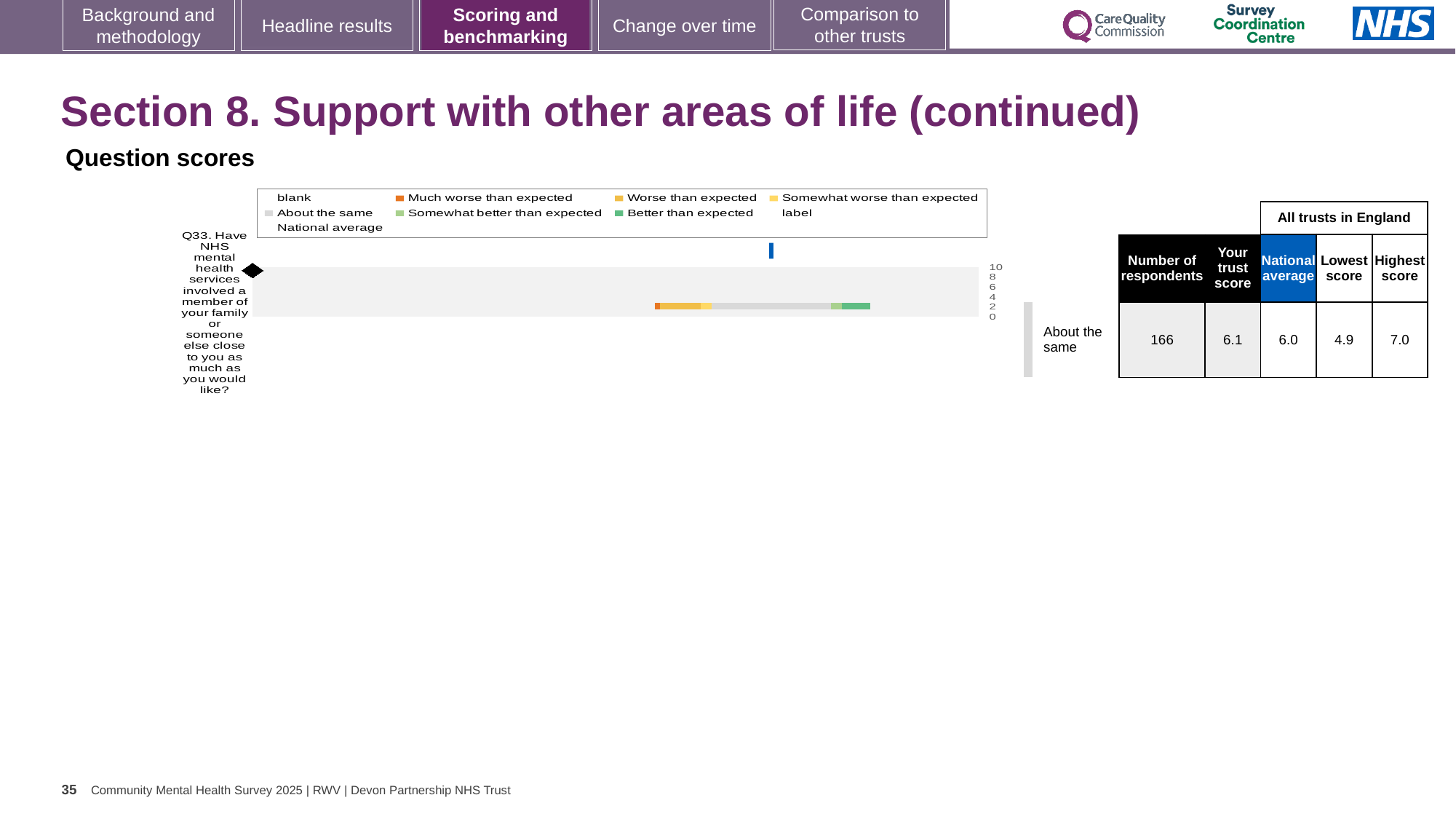
What is the highest value shown on the chart's axis? 10 How many entries does the chart legend list? 9 Which question is plotted in the chart? Q33. Have NHS mental health services involved a member of your family or someone else close to you as much as you would like? In the table beside the chart, what is the difference between the highest score and the lowest score for Q33? 2.1 What benchmark category label is shown next to the bar for Q33? About the same Which legend entry is shown in orange? Much worse than expected In the table beside the chart, what is the trust score for Q33? 6.1 What kind of chart is shown on the slide? bar chart In the table beside the chart, how many respondents answered Q33? 166 In the table beside the chart, what is the national average for Q33? 6.0 In the table beside the chart, is the trust score for Q33 higher or lower than the national average? higher How many questions are plotted in the chart? 1